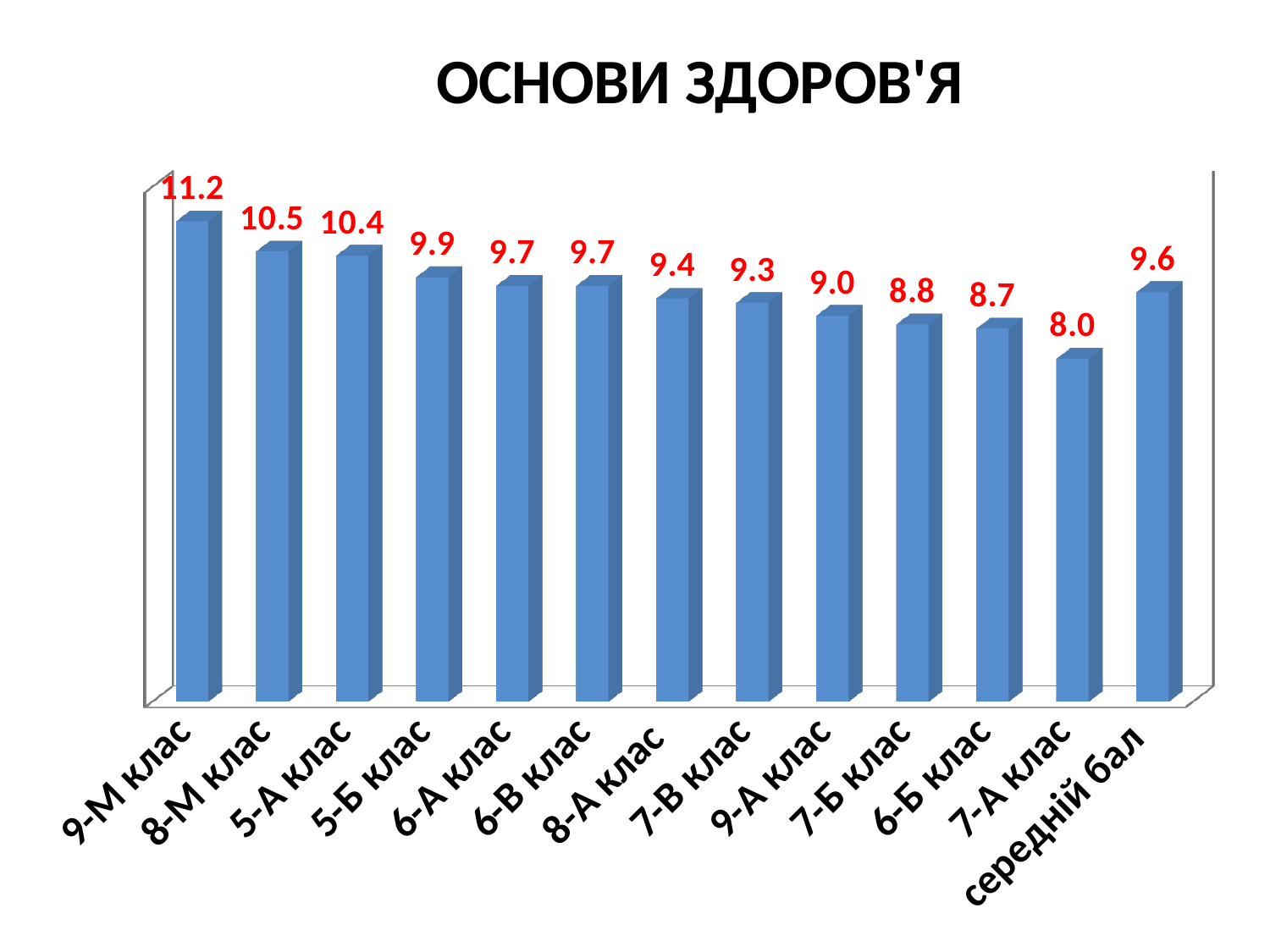
What is the title of the chart? ОСНОВИ ЗДОРОВ'Я Which class has the lowest value? 7-А клас What is the value for 6-Б клас? 8.7 How many bars are shown in the chart? 13 What is the difference between the values for 8-М клас and 5-А клас? 0.1 Which is larger, the value for 5-Б клас or the value for 9-А клас? 5-Б клас What is the value for 9-М клас? 11.2 Which class has the highest value? 9-М клас What is the difference between the values for 9-М клас and 7-А клас? 3.2 What is the value for 7-А клас? 8.0 What is the value shown for середній бал? 9.6 What kind of chart is shown on the slide? Bar chart